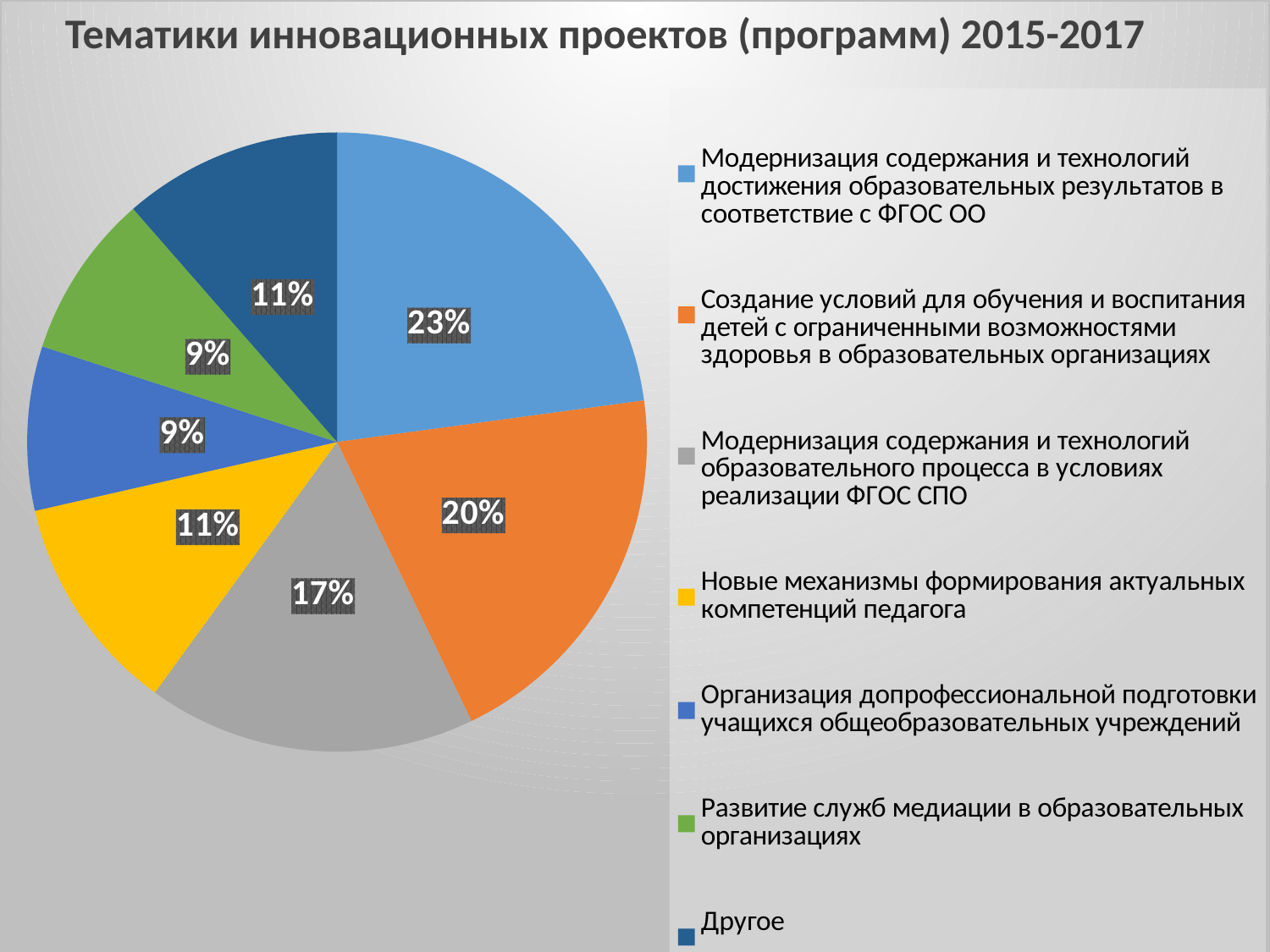
What is the value for "Модернизация содержания и технологий образовательного процесса в условиях реализации ФГОС СПО"? 17% What is the title of the chart? Тематики инновационных проектов (программ) 2015-2017 How many entries does the legend list? 7 What kind of chart is shown on the slide? pie chart Which is larger: the slice for "Модернизация содержания и технологий образовательного процесса в условиях реализации ФГОС СПО" or the slice for "Другое"? Модернизация содержания и технологий образовательного процесса в условиях реализации ФГОС СПО What is the difference between the largest slice (23%) and the slice for "Создание условий для обучения и воспитания детей с ограниченными возможностями здоровья в образовательных организациях"? 3% What is the value for "Развитие служб медиации в образовательных организациях"? 9% How many slices does the pie chart have? 7 What colour is the slice for "Организация допрофессиональной подготовки учащихся общеобразовательных учреждений"? blue What share of the pie does "Другое" take? 11% What is the value for "Новые механизмы формирования актуальных компетенций педагога"? 11% Which category has the largest slice of the pie? Модернизация содержания и технологий достижения образовательных результатов в соответствие с ФГОС ОО